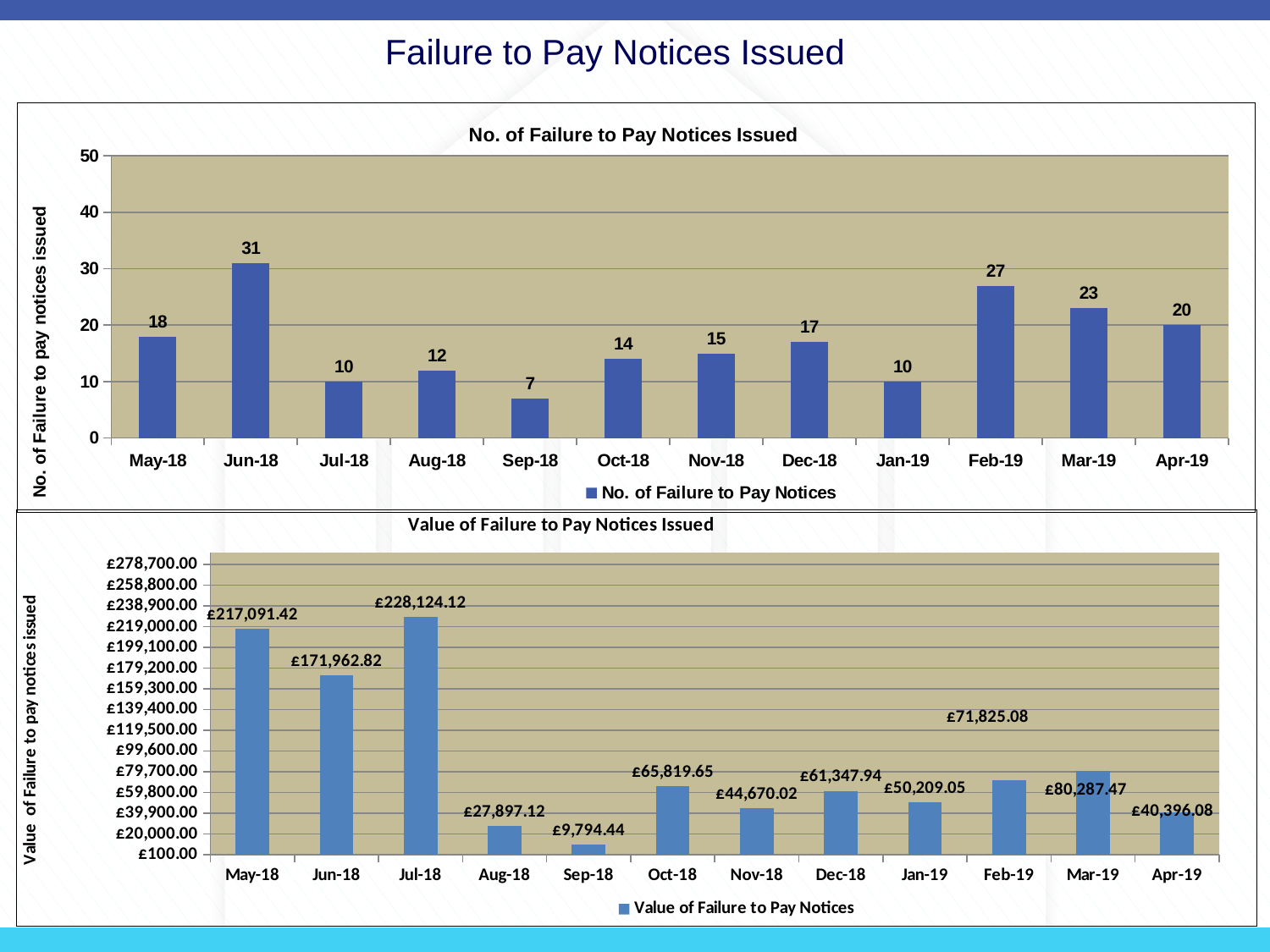
In the 'No. of Failure to Pay Notices Issued' chart, which month has the highest number of notices? Jun-18 In the 'No. of Failure to Pay Notices Issued' chart, which month has the lowest number of notices? Sep-18 In the 'Value of Failure to Pay Notices Issued' chart, what is the value for Sep-18? £9,794.44 In the 'No. of Failure to Pay Notices Issued' chart, how many months are shown on the x axis? 12 In the 'Value of Failure to Pay Notices Issued' chart, which is larger: the value for Mar-19 or the value for Apr-19? Mar-19 In the 'Value of Failure to Pay Notices Issued' chart, which month has the highest value? Jul-18 In the 'Value of Failure to Pay Notices Issued' chart, what is the value for Jul-18? £228,124.12 In the 'No. of Failure to Pay Notices Issued' chart, what is the difference between the number of notices in Feb-19 and Mar-19? 4 How many series does the legend of the 'No. of Failure to Pay Notices Issued' chart list? 1 In the 'No. of Failure to Pay Notices Issued' chart, which is larger: the value for Dec-18 or the value for Oct-18? Dec-18 In the 'No. of Failure to Pay Notices Issued' chart, how many notices were issued in Jun-18? 31 What kind of chart is the 'Value of Failure to Pay Notices Issued' chart? Bar chart